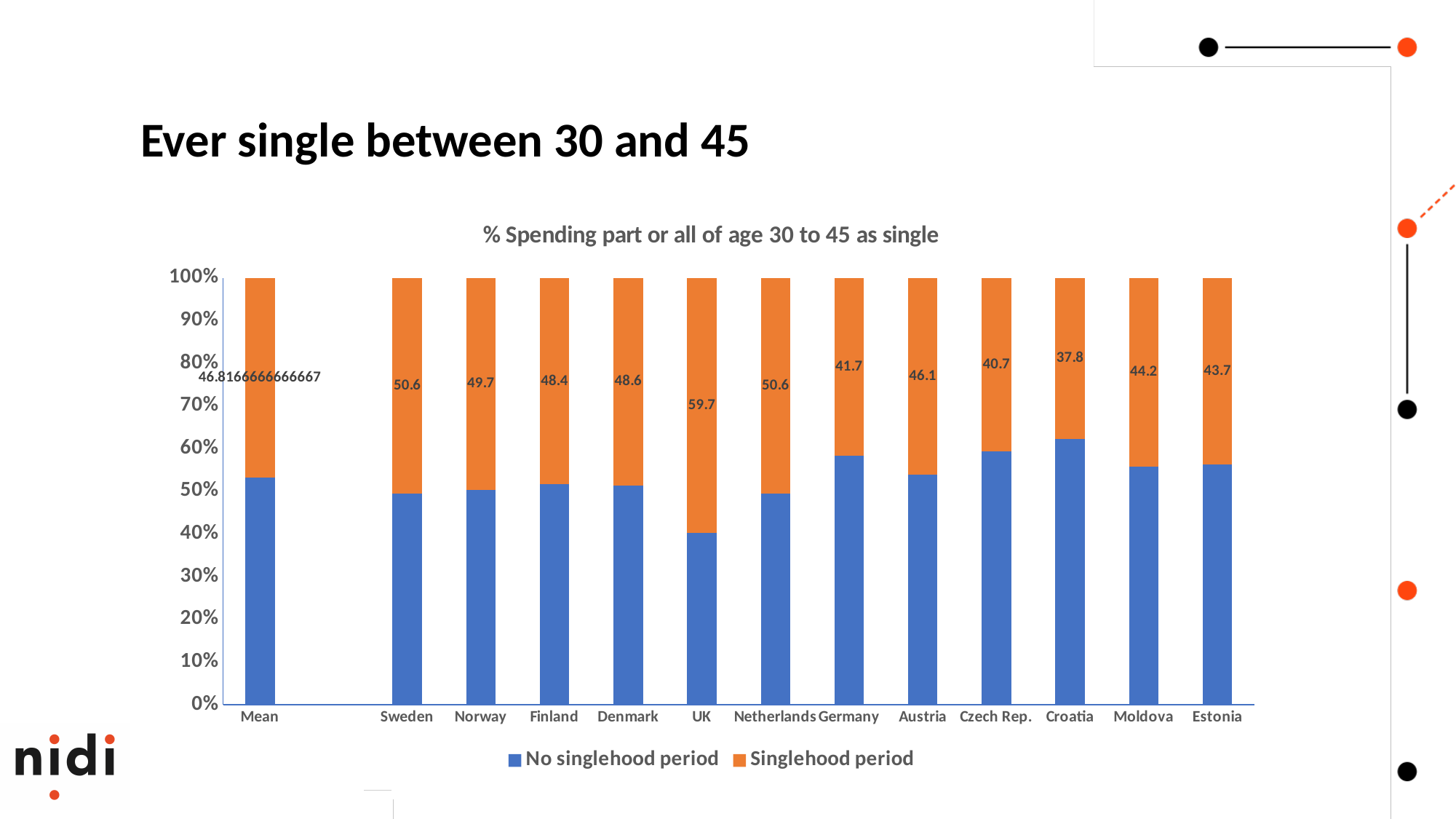
What is the title of the chart? % Spending part or all of age 30 to 45 as single What is the Singlehood period value for Croatia? 37.8 How many categories are shown on the x axis? 13 What is the Singlehood period value for Germany? 41.7 What is the difference between the Singlehood period values for the UK and Croatia? 21.9 What kind of chart is shown on the slide? Stacked bar chart What is the Singlehood period value for the UK? 59.7 How many series does the legend list? 2 Which country has the highest Singlehood period value? UK Is the No singlehood period share for the UK greater or less than 50%? less Which has a larger Singlehood period value, Sweden or Austria? Sweden Which country has the lowest Singlehood period value? Croatia